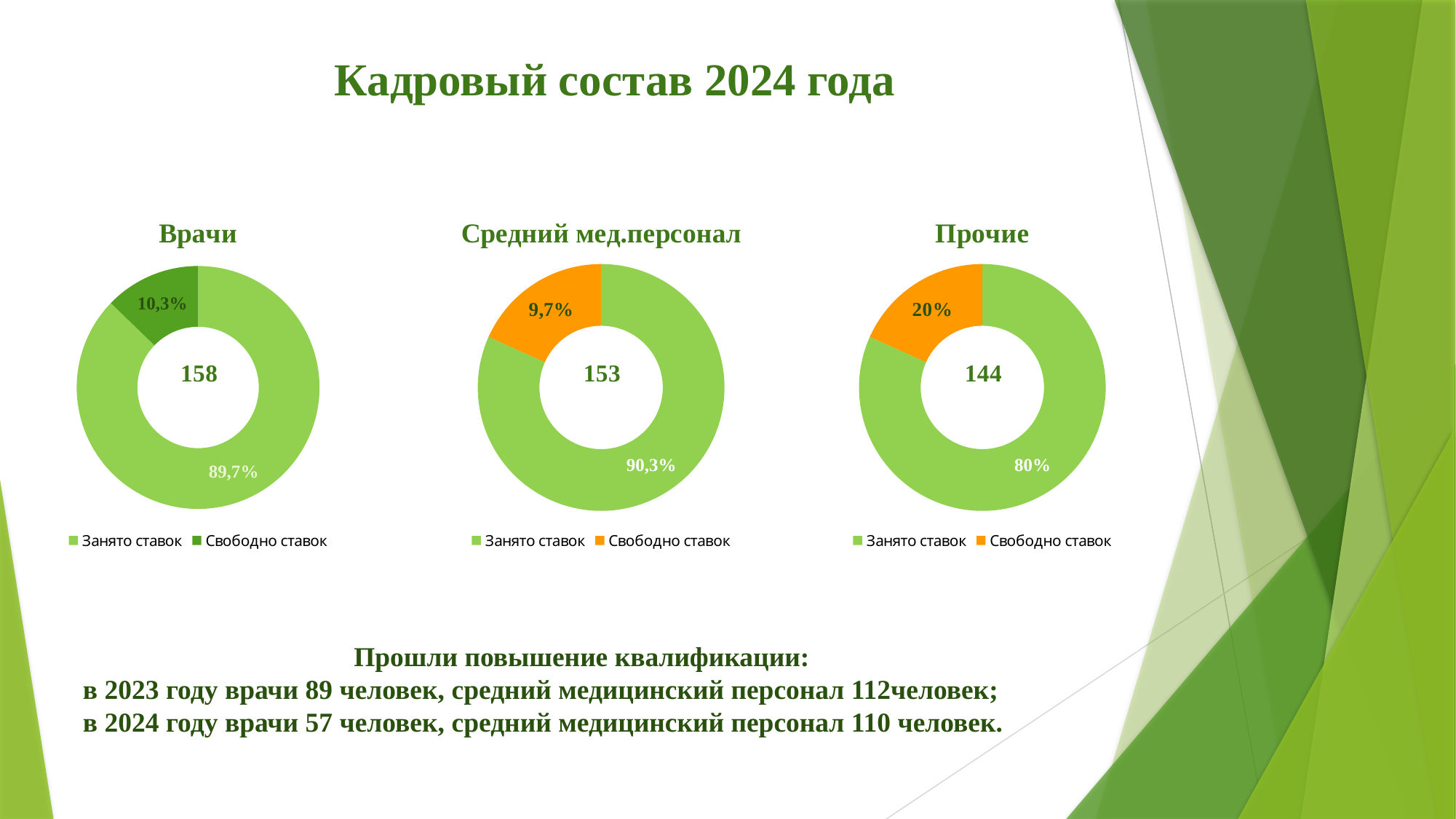
In the 'Прочие' chart, which slice is larger, 'Занято ставок' or 'Свободно ставок'? Занято ставок In the 'Средний мед.персонал' chart, what colour is the 'Свободно ставок' slice? Orange What number is shown in the centre of the 'Прочие' chart? 144 In the 'Средний мед.персонал' chart, what share is labelled for 'Свободно ставок'? 9,7% How many doughnut charts are on the slide? 3 In the 'Врачи' chart, what share is labelled for 'Занято ставок'? 89,7% What number is shown in the centre of the 'Врачи' chart? 158 How many entries does the legend of the 'Врачи' chart list? 2 In the 'Прочие' chart, what share is labelled for 'Свободно ставок'? 20% What kind of chart is the 'Средний мед.персонал' chart? Doughnut chart In the 'Средний мед.персонал' chart, what share is labelled for 'Занято ставок'? 90,3% In the 'Врачи' chart, what share is labelled for 'Свободно ставок'? 10,3%